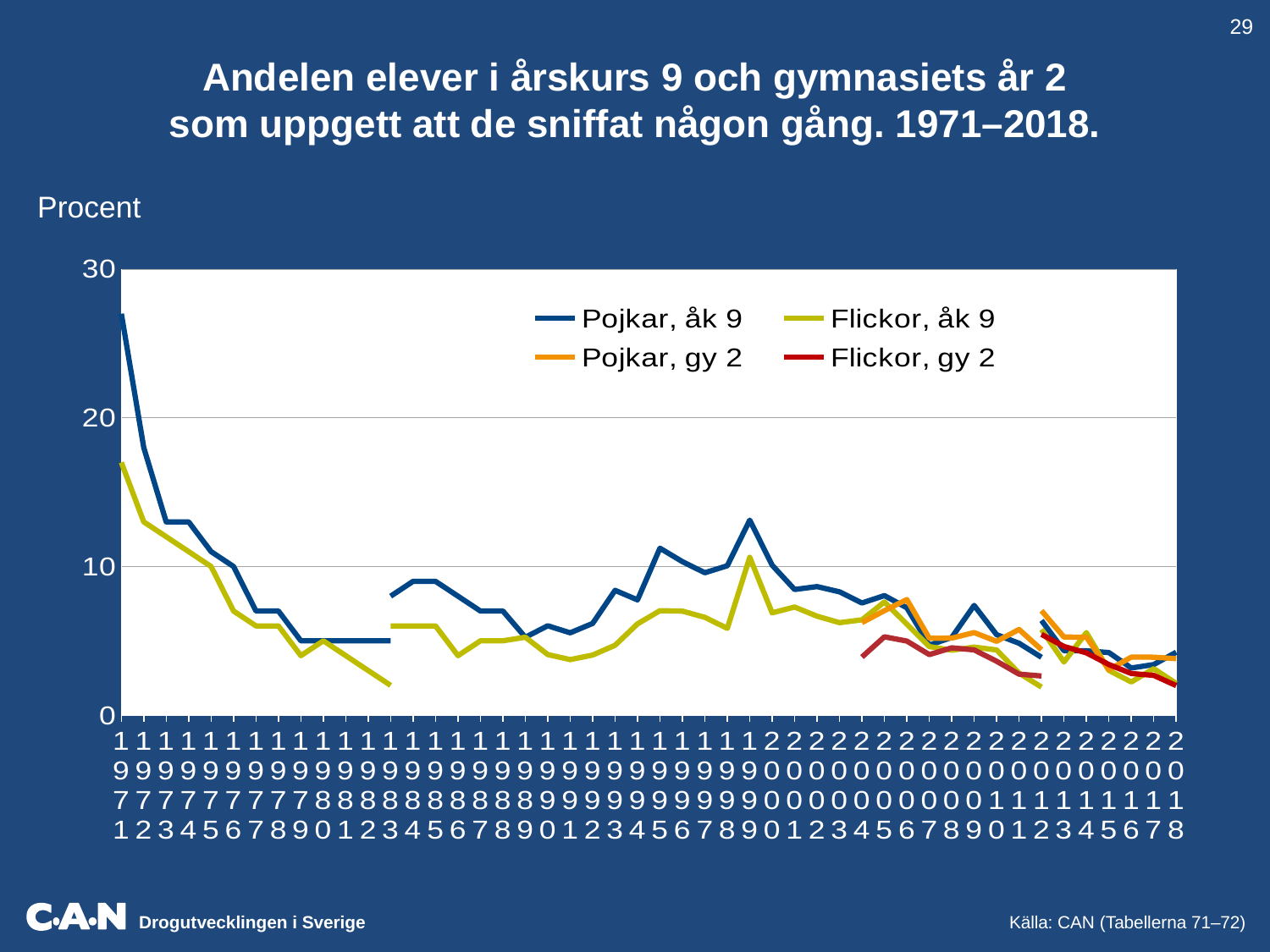
What is the unit label shown above the y axis? Procent What kind of chart is shown on the slide? line chart Is the value for Pojkar, åk 9 in 1989 greater or less than 10? less Is the value for Pojkar, åk 9 in 1971 greater or less than 20? greater Is the value for Flickor, åk 9 in 1971 greater or less than 10? greater Which series are listed in the legend? Pojkar, åk 9; Pojkar, gy 2; Flickor, åk 9; Flickor, gy 2 How many series does the legend list? 4 Which series has the highest value in 1971? Pojkar, åk 9 What is the highest value shown on the y axis? 30 Do the values for Pojkar, åk 9 rise or fall from 1971 to 1980? fall In 1971, which is larger: the value for Pojkar, åk 9 or the value for Flickor, åk 9? Pojkar, åk 9